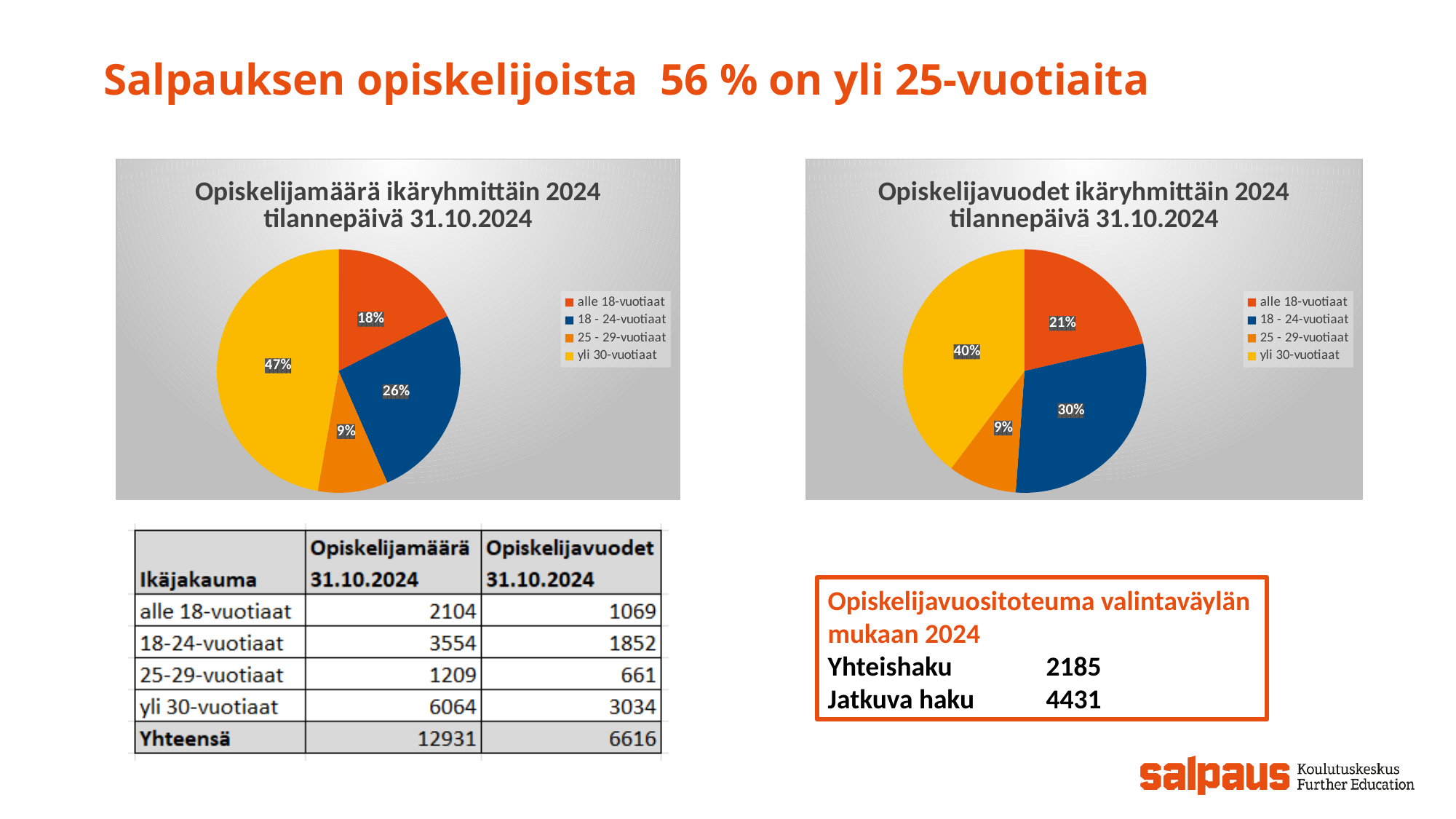
In the left chart (Opiskelijamäärä ikäryhmittäin 2024), what colour is the yli 30-vuotiaat slice? Yellow In the right chart (Opiskelijavuodet ikäryhmittäin 2024), what share of the pie is the yli 30-vuotiaat slice? 40% In the right chart (Opiskelijavuodet ikäryhmittäin 2024), what percentage is shown for alle 18-vuotiaat? 21% In the right chart (Opiskelijavuodet ikäryhmittäin 2024), which age group has the smallest slice? 25 - 29-vuotiaat In the right chart (Opiskelijavuodet ikäryhmittäin 2024), which is larger: the 18 - 24-vuotiaat slice or the alle 18-vuotiaat slice? 18 - 24-vuotiaat In the left chart (Opiskelijamäärä ikäryhmittäin 2024), what is the difference in percentage points between the yli 30-vuotiaat slice and the 18 - 24-vuotiaat slice? 21 percentage points In the left chart (Opiskelijamäärä ikäryhmittäin 2024), what share of the pie is the yli 30-vuotiaat slice? 47% In the left chart (Opiskelijamäärä ikäryhmittäin 2024), which age group has the largest slice? yli 30-vuotiaat How many entries does the legend of the right chart (Opiskelijavuodet ikäryhmittäin 2024) list? 4 What type of chart is the right chart (Opiskelijavuodet ikäryhmittäin 2024)? Pie chart In the left chart (Opiskelijamäärä ikäryhmittäin 2024), what percentage is shown for 18 - 24-vuotiaat? 26% How many slices does the left chart (Opiskelijamäärä ikäryhmittäin 2024) have? 4